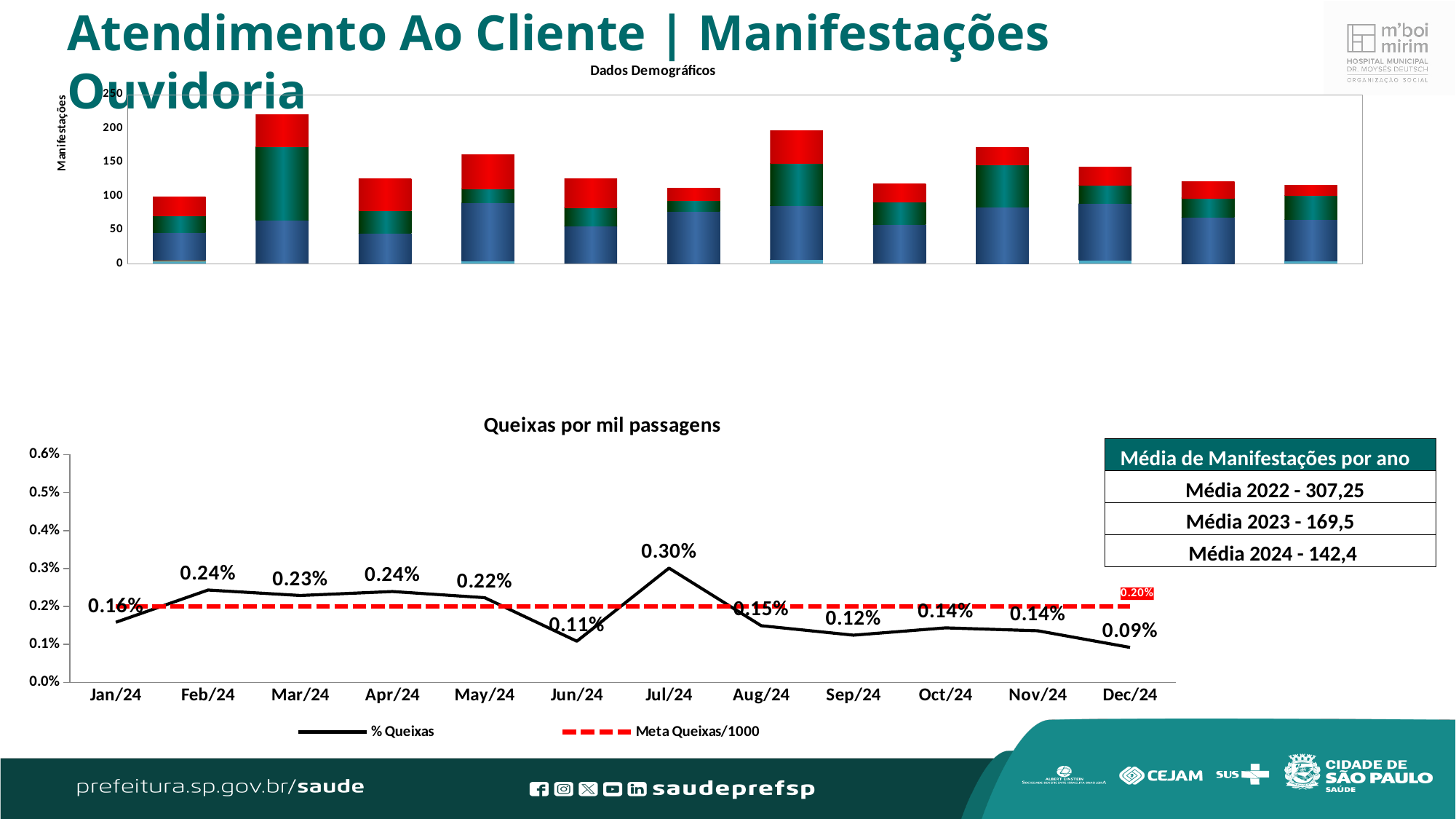
In the bottom chart 'Queixas por mil passagens', how many months are plotted on the x axis? 12 How many bars are plotted in the top chart 'Dados Demográficos'? 12 In the bottom chart 'Queixas por mil passagens', which month has the lowest % Queixas value? Dec/24 What type of chart is the top chart titled 'Dados Demográficos'? bar chart In the bottom chart 'Queixas por mil passagens', does the % Queixas value rise or fall from Jul/24 to Sep/24? fall In the bottom chart 'Queixas por mil passagens', which month has the highest % Queixas value? Jul/24 In the bottom chart 'Queixas por mil passagens', what is the % Queixas value for Jul/24? 0.30% In the bottom chart 'Queixas por mil passagens', what is the % Queixas value for Dec/24? 0.09% In the bottom chart 'Queixas por mil passagens', which is larger, the % Queixas value for Feb/24 or for Jun/24? Feb/24 How many series does the legend of the bottom chart 'Queixas por mil passagens' list? 2 What type of chart is the bottom chart 'Queixas por mil passagens'? line chart In the bottom chart 'Queixas por mil passagens', what is the difference between the % Queixas values for Jul/24 and Dec/24? 0.21%